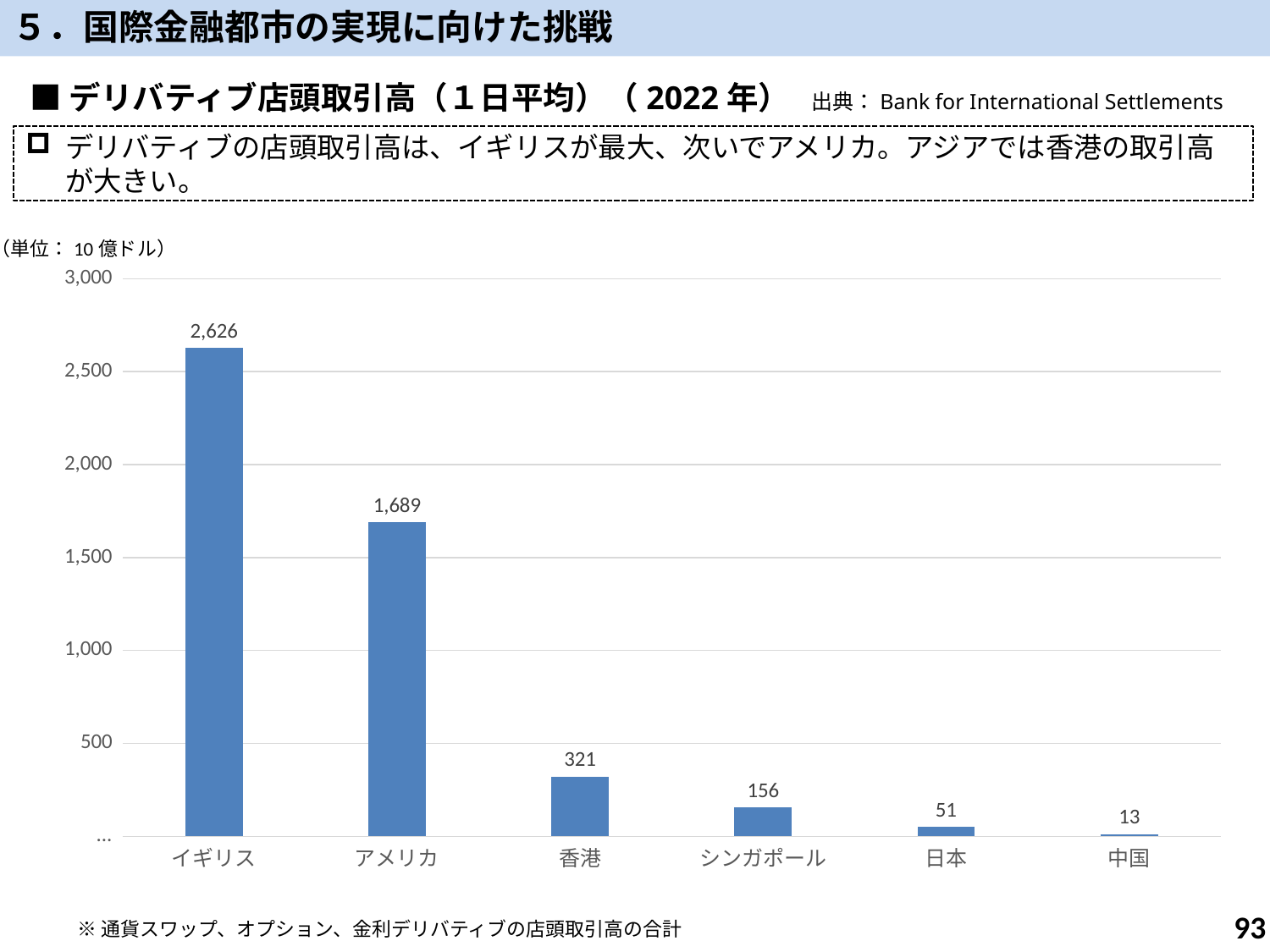
Which is larger, the value for シンガポール or the value for 日本? シンガポール Do the values rise or fall from left to right along the x axis? fall How many categories are shown on the x axis? 6 What is the value for 日本? 51 What is the value for イギリス? 2,626 What kind of chart is shown? bar chart Is the value for アメリカ greater or less than 1,500? greater What is the value for 香港? 321 Which category has the highest value? イギリス What is the difference between the values for イギリス and アメリカ? 937 Which category has the lowest value? 中国 What is the difference between the values for 香港 and シンガポール? 165